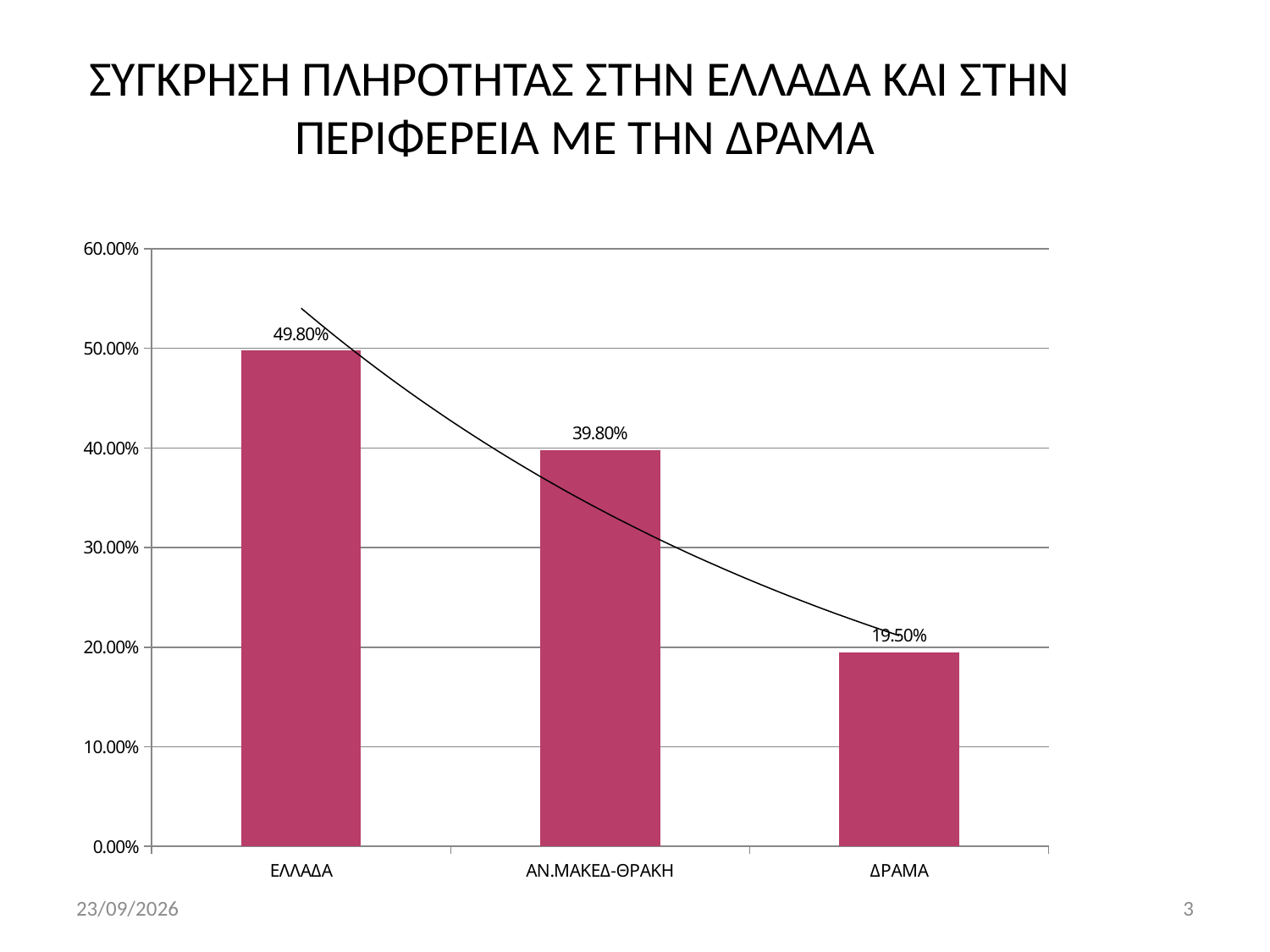
What kind of chart is shown on the slide? bar chart What is the difference between the values for ΕΛΛΑΔΑ and ΔΡΑΜΑ? 30.30% How many categories are shown on the x axis? 3 Which category has the highest value? ΕΛΛΑΔΑ What is the value for ΕΛΛΑΔΑ? 49.80% Do the values rise or fall from left to right along the x axis? fall What is the value for ΑΝ.ΜΑΚΕΔ-ΘΡΑΚΗ? 39.80% What is the value for ΔΡΑΜΑ? 19.50% Which is larger, the value for ΑΝ.ΜΑΚΕΔ-ΘΡΑΚΗ or the value for ΔΡΑΜΑ? ΑΝ.ΜΑΚΕΔ-ΘΡΑΚΗ What is the difference between the values for ΕΛΛΑΔΑ and ΑΝ.ΜΑΚΕΔ-ΘΡΑΚΗ? 10.00% Is the value for ΔΡΑΜΑ greater or less than 20.00%? less Which category has the lowest value? ΔΡΑΜΑ